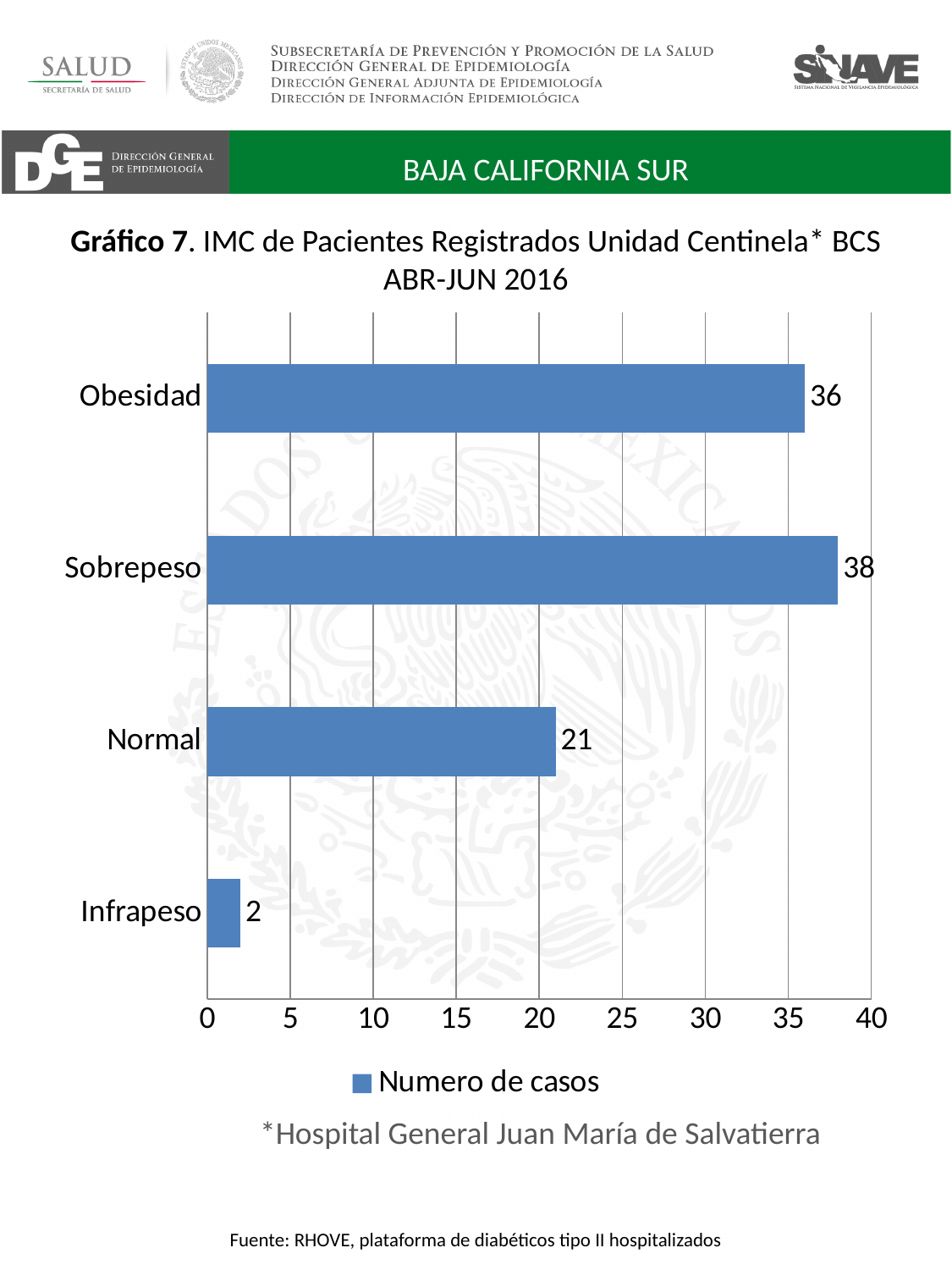
What is the number of cases for Obesidad? 36 What is the difference between the number of cases for Sobrepeso and Normal? 17 What is the number of cases for Normal? 21 How many categories are shown in the chart? 4 Which category has the highest number of cases? Sobrepeso Which has more cases, Obesidad or Normal? Obesidad What series name does the legend show? Numero de casos What kind of chart is shown on the slide? Bar chart Which category has the lowest number of cases? Infrapeso What is the number of cases for Sobrepeso? 38 Is the value for Normal greater or less than 25? less What is the number of cases for Infrapeso? 2